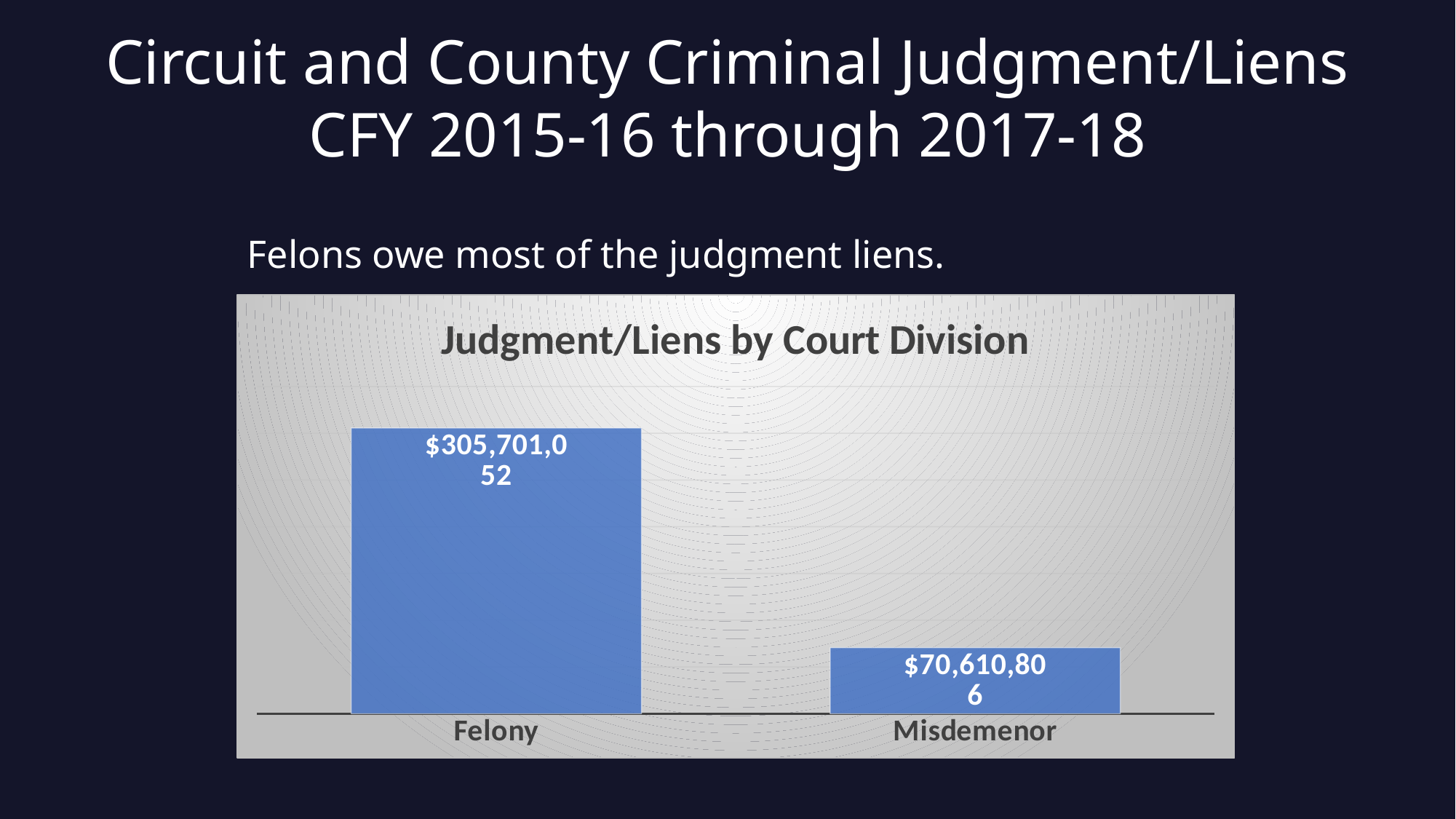
What is the combined total of the Felony and Misdemenor values? $376,311,858 What is the difference between the Felony and Misdemenor values? $235,090,246 What is the title of the chart on the slide? Judgment/Liens by Court Division How many categories are shown in the Judgment/Liens by Court Division chart? 2 What colour are the bars in the chart? Blue What is the value for Misdemenor in the Judgment/Liens by Court Division chart? $70,610,806 Which court division has the lowest judgment/liens value? Misdemenor Which court division has the highest judgment/liens value? Felony What is the value for Felony in the Judgment/Liens by Court Division chart? $305,701,052 Which is larger, the value for Felony or the value for Misdemenor? Felony What kind of chart is shown on the slide? Bar chart